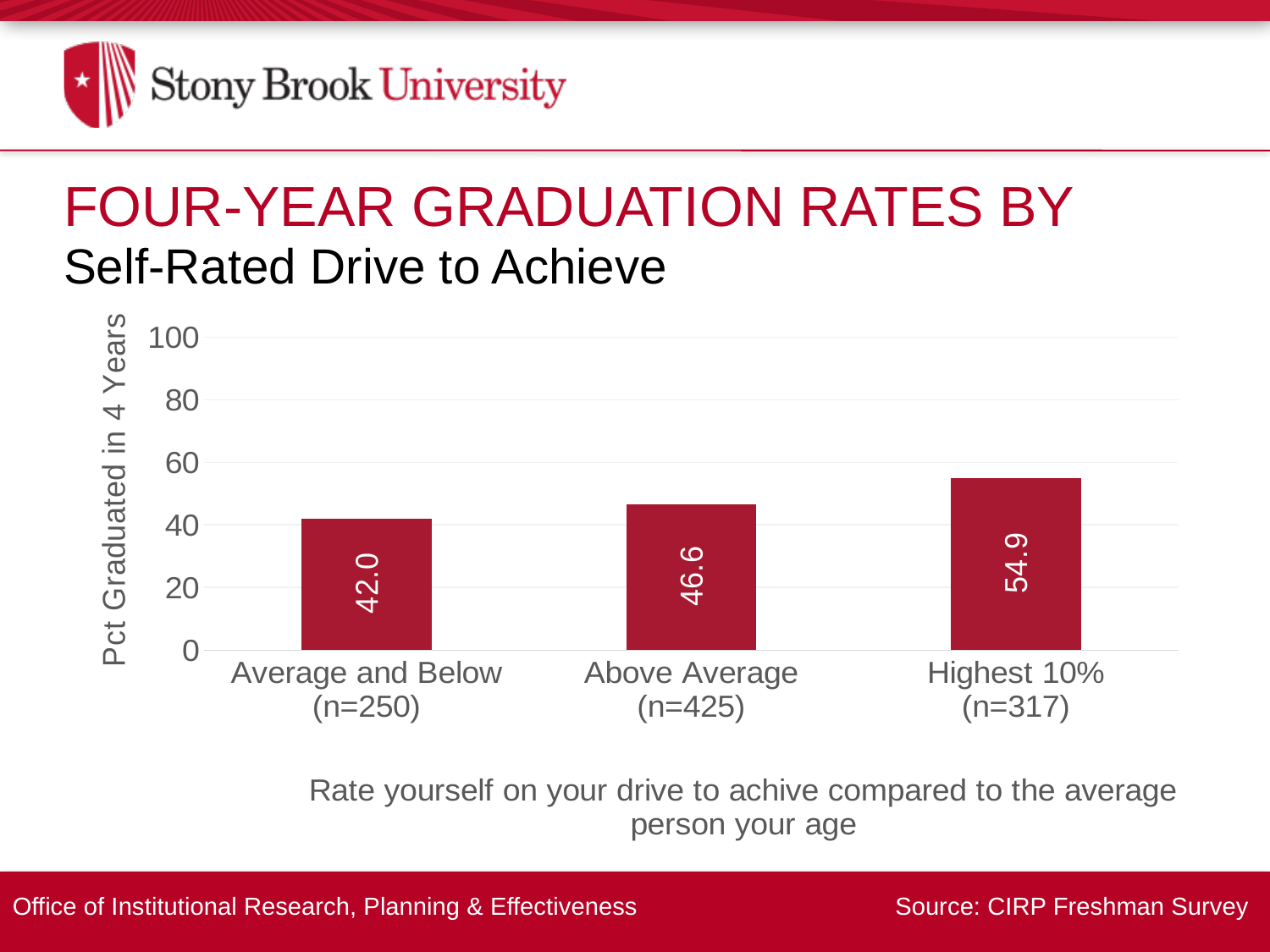
What is the difference in four-year graduation rate between the Highest 10% group and the Average and Below group? 12.9 Which self-rated drive to achieve group has the lowest four-year graduation rate? Average and Below What type of chart is used to show four-year graduation rates by self-rated drive to achieve? Bar chart Which self-rated drive to achieve group has the highest four-year graduation rate? Highest 10% Is the four-year graduation rate for the Highest 10% group greater or less than 60? less Do the four-year graduation rates rise or fall as self-rated drive to achieve increases from Average and Below to Highest 10%? Rise What is the difference in four-year graduation rate between the Above Average group and the Average and Below group? 4.6 How many self-rated drive to achieve groups are shown in the chart? 3 What is the four-year graduation rate for the Highest 10% group? 54.9 Which group has a higher four-year graduation rate, Above Average or Highest 10%? Highest 10% What is the four-year graduation rate for the Above Average group? 46.6 What is the four-year graduation rate for students who rated their drive to achieve as Average and Below? 42.0